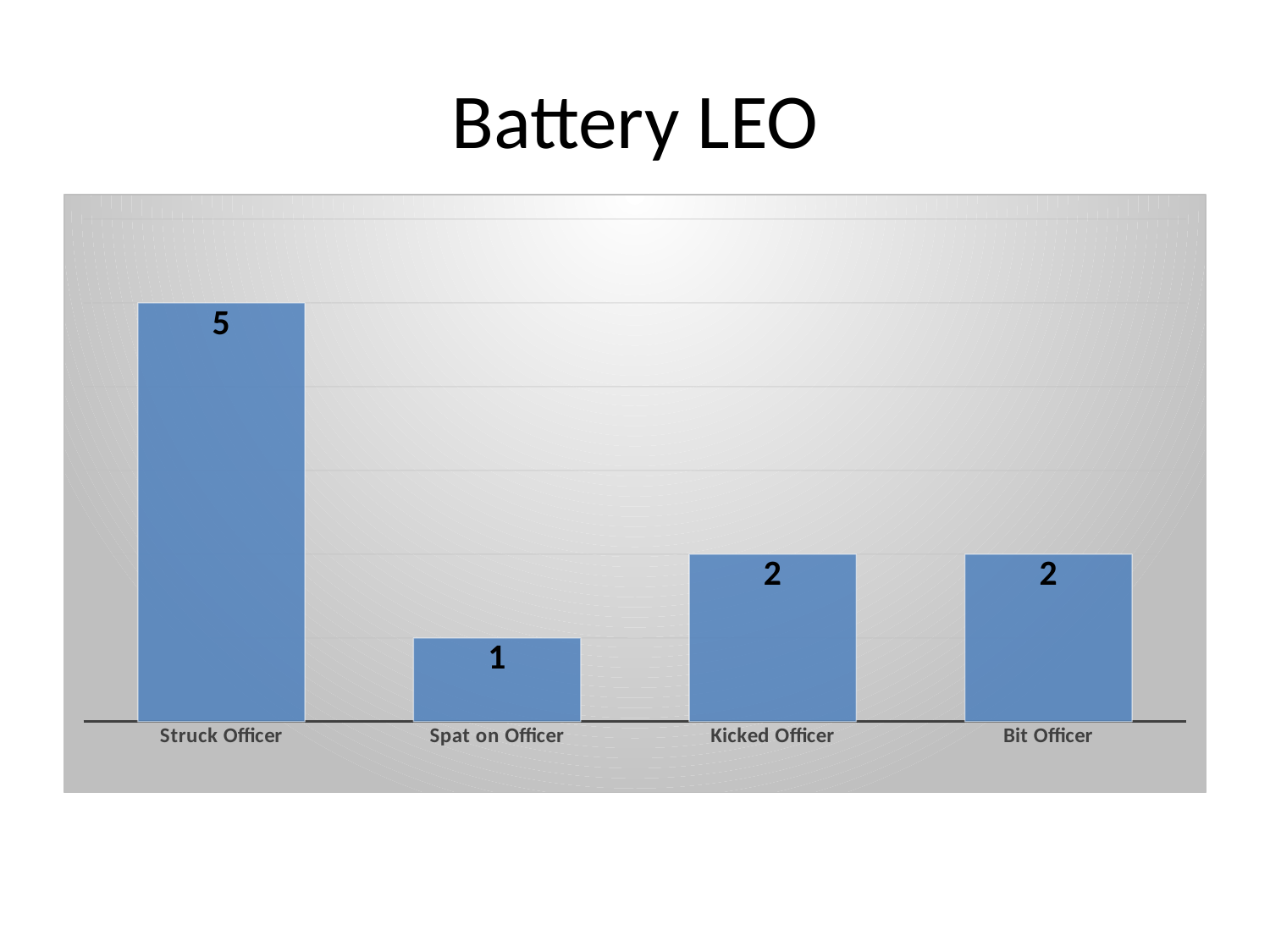
What is the difference between the values for Struck Officer and Kicked Officer? 3 What is the value for Struck Officer? 5 What is the value for Kicked Officer? 2 What is the difference between the values for Struck Officer and Spat on Officer? 4 Which category has the highest value? Struck Officer What kind of chart is shown on the slide? Bar chart What is the title of the slide? Battery LEO Which is larger, the value for Struck Officer or the value for Bit Officer? Struck Officer What is the value for Spat on Officer? 1 Which category has the lowest value? Spat on Officer How many categories are shown on the chart? 4 What is the value for Bit Officer? 2